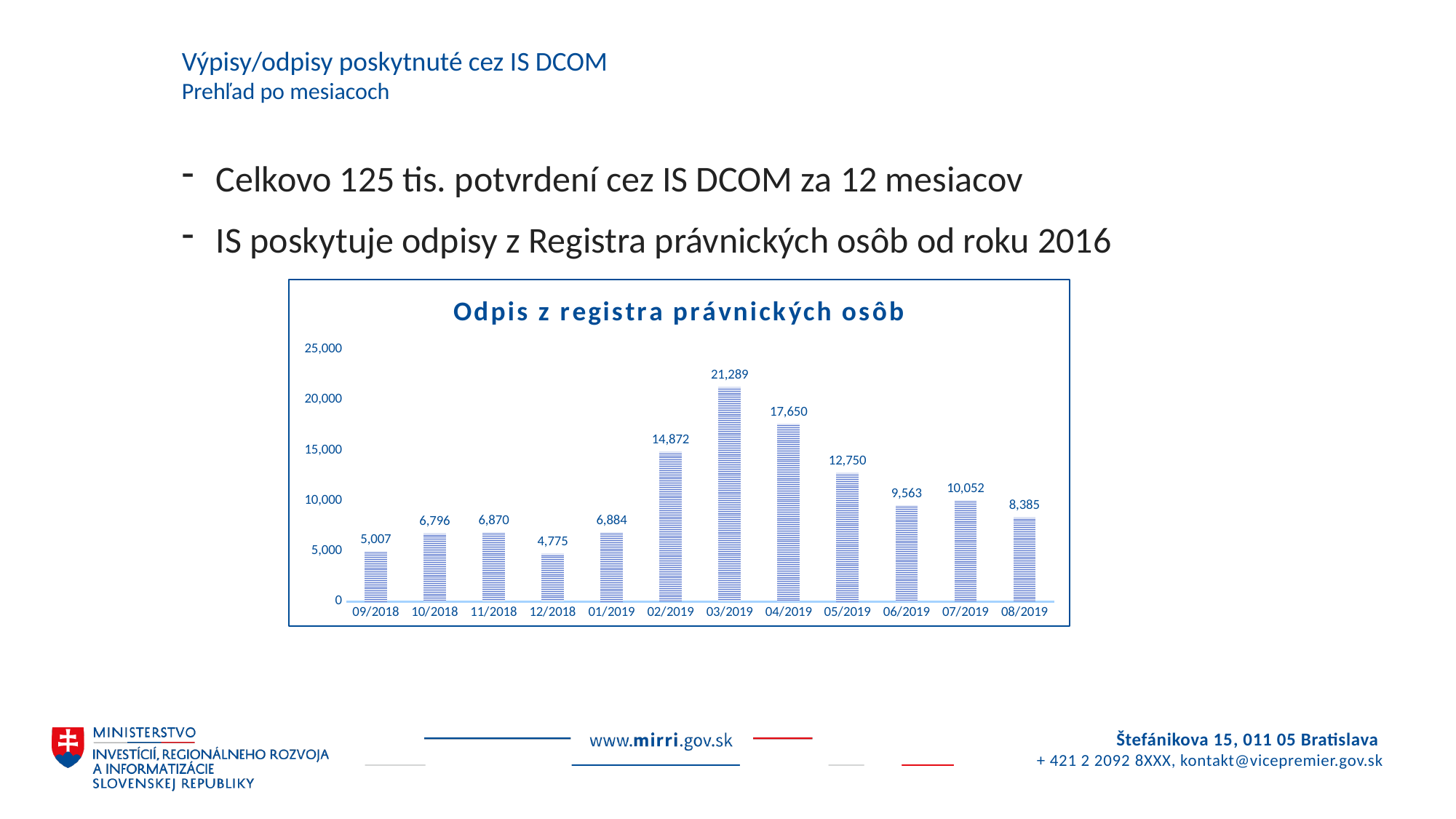
What kind of chart is shown? bar chart What is the difference between the values for 03/2019 and 04/2019? 3,639 Do the values rise or fall from 03/2019 to 06/2019? fall Is the value for 06/2019 greater or less than 10,000? less Which month has the highest value? 03/2019 Which month has the lowest value? 12/2018 What is the value for 12/2018? 4,775 What is the value for 03/2019? 21,289 What is the value for 07/2019? 10,052 Which is larger, the value for 02/2019 or the value for 05/2019? 02/2019 How many months are shown on the x axis? 12 What is the title of the chart? Odpis z registra právnických osôb